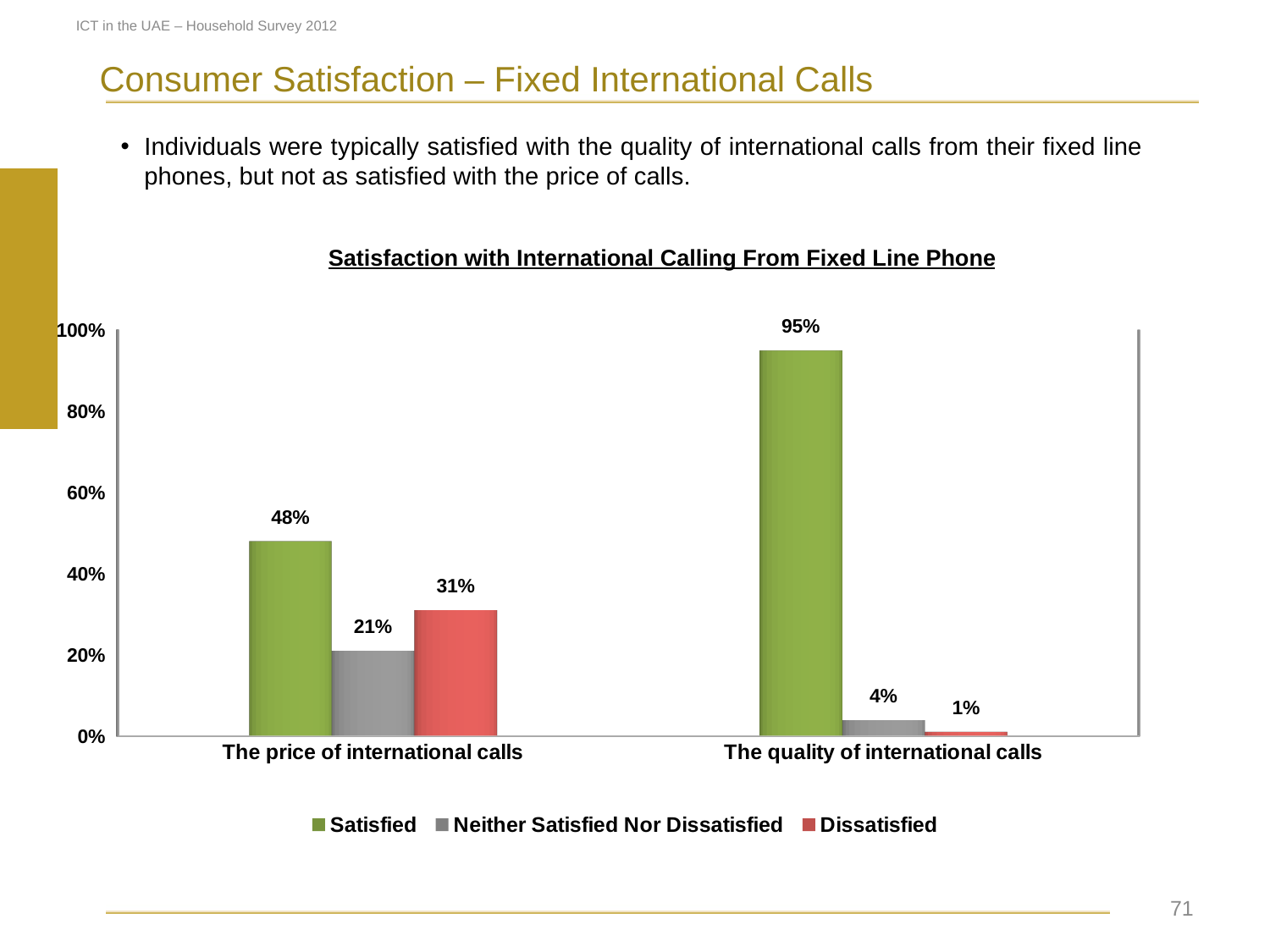
What percentage of individuals were dissatisfied with the quality of international calls? 1% What is the value for 'Neither Satisfied Nor Dissatisfied' for the price of international calls? 21% What percentage of individuals were satisfied with the quality of international calls? 95% Which category has the highest 'Satisfied' value? The quality of international calls How many categories are shown on the x axis? 2 What is the difference between the 'Satisfied' values for the quality and the price of international calls? 47% What percentage of individuals were satisfied with the price of international calls? 48% Which series has the lowest value for the quality of international calls? Dissatisfied Which is larger for the price of international calls: 'Dissatisfied' or 'Neither Satisfied Nor Dissatisfied'? Dissatisfied What kind of chart is shown on the slide? Bar chart How many series does the legend list? 3 Is the 'Dissatisfied' value for the price of international calls greater or less than 40%? less